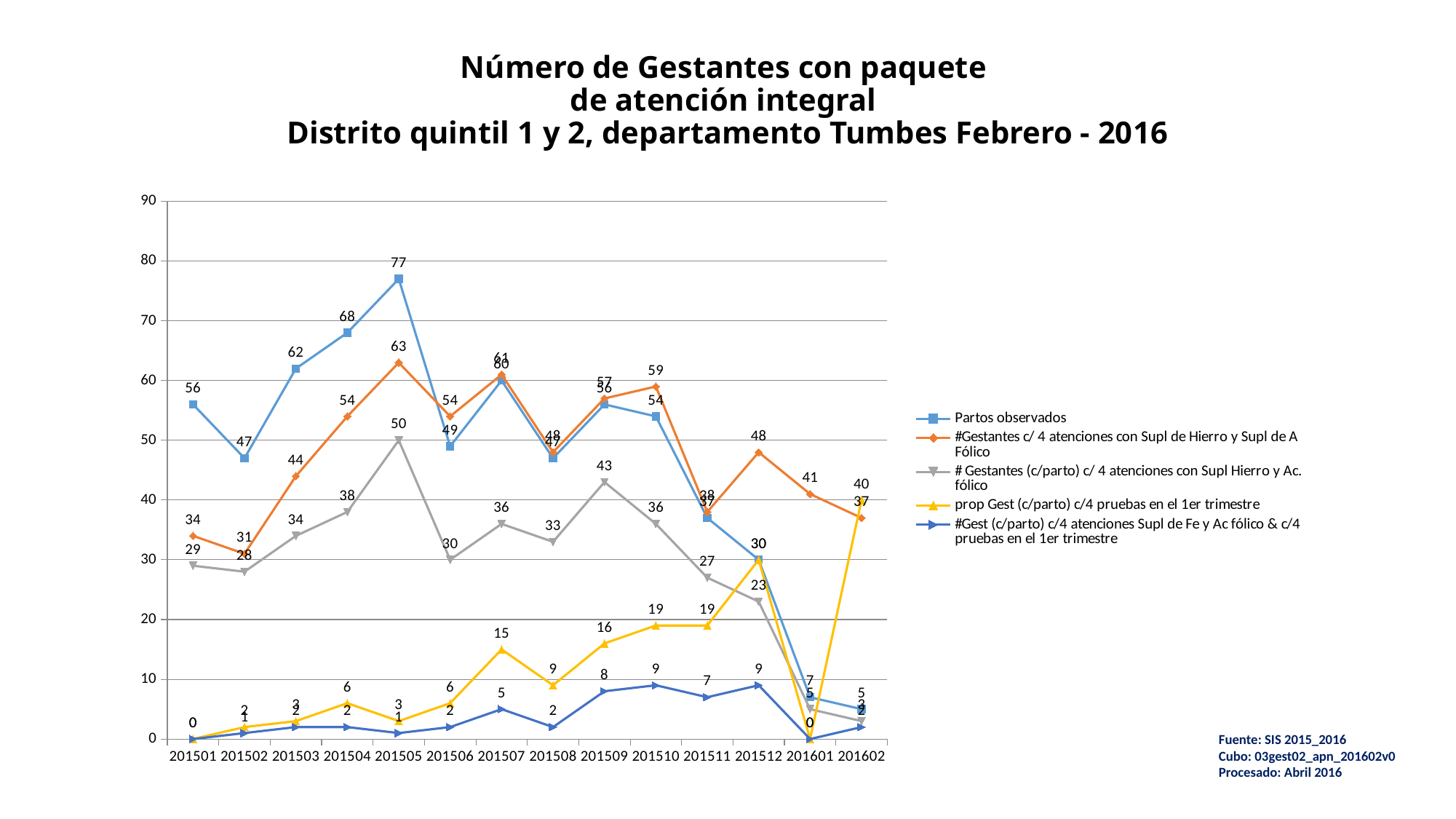
What is the value of Partos observados for 201505? 77 How many series does the legend list? 5 What is the value of 'prop Gest (c/parto) c/4 pruebas en el 1er trimestre' for 201602? 40 Does Partos observados rise or fall from 201510 to 201601? fall What is the value of '#Gestantes c/ 4 atenciones con Supl de Hierro y Supl de A Fólico' for 201512? 48 What is the value of '# Gestantes (c/parto) c/ 4 atenciones con Supl Hierro y Ac. fólico' for 201509? 43 What type of chart is shown on the slide? line chart What is the difference between Partos observados in 201505 and 201504? 9 In which period is Partos observados highest? 201505 In which period is Partos observados lowest? 201602 Which is larger for Partos observados: 201503 or 201504? 201504 How many time periods are shown on the x axis? 14